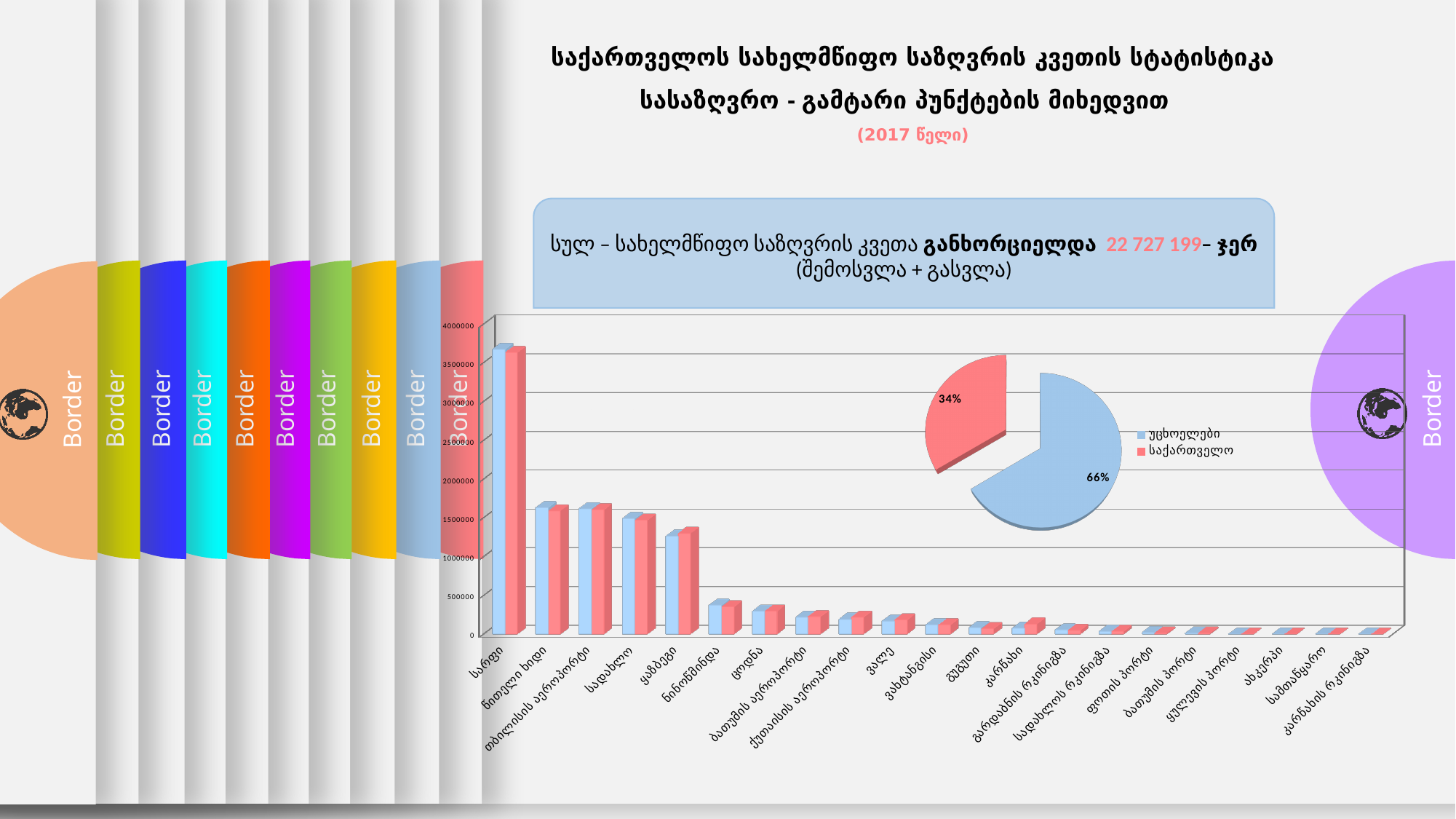
What kind of chart is the large chart at the bottom of the slide? bar chart In the bar chart, do the values generally rise or fall moving from left to right along the x axis? fall In the pie chart, what share is labelled on the red slice? 34% How many entries does the legend next to the pie chart list? 2 What kind of chart is the chart on the right side of the slide with the 34% and 66% labels? pie chart In the bar chart, which category has the highest bars? სარფი How many categories are shown on the x axis of the bar chart? 21 In the pie chart, which slice is larger, უცხოელები or საქართველო? უცხოელები In the bar chart, are the values for სარფი greater or less than 3500000? greater In the bar chart, are the values for ნინოწმინდა greater or less than 500000? less In the pie chart, what share is labelled on the blue slice? 66% How many slices does the pie chart have? 2